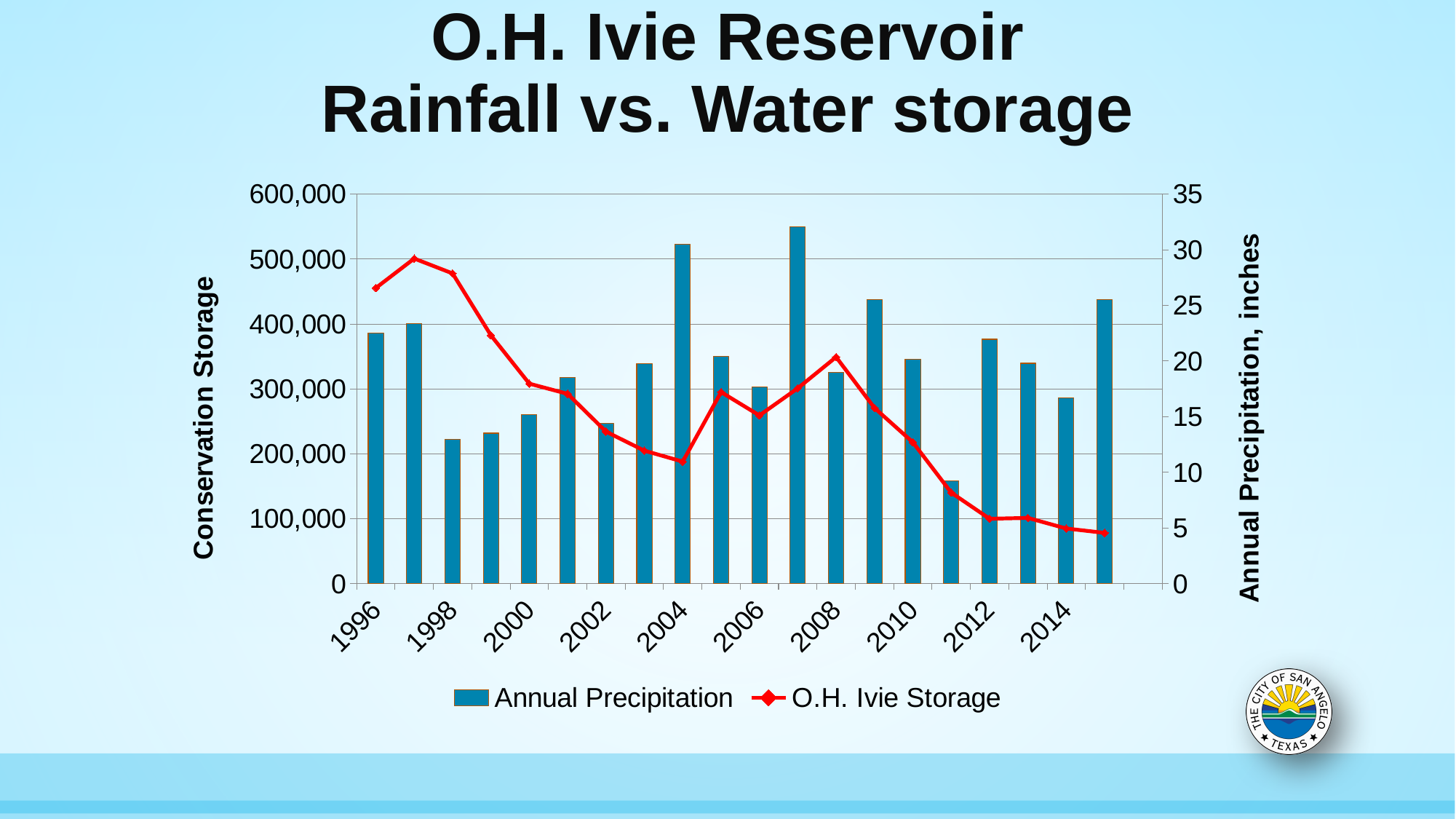
What kind of chart is shown on the slide? A bar chart combined with a line chart In which year does the O.H. Ivie Storage line reach its lowest point? 2015 How many series does the legend list? 2 Which year has the highest Annual Precipitation bar? 2007 How many years (bars) are plotted for Annual Precipitation? 20 Is the Annual Precipitation for 2004 greater or less than 25 inches? greater Which year has the lowest Annual Precipitation bar? 2011 Which series is drawn as a red line? O.H. Ivie Storage Is the O.H. Ivie Storage value for 2015 greater or less than 100,000? less In which year does the O.H. Ivie Storage line reach its highest point? 1997 Which year has the higher Annual Precipitation, 2009 or 2010? 2009